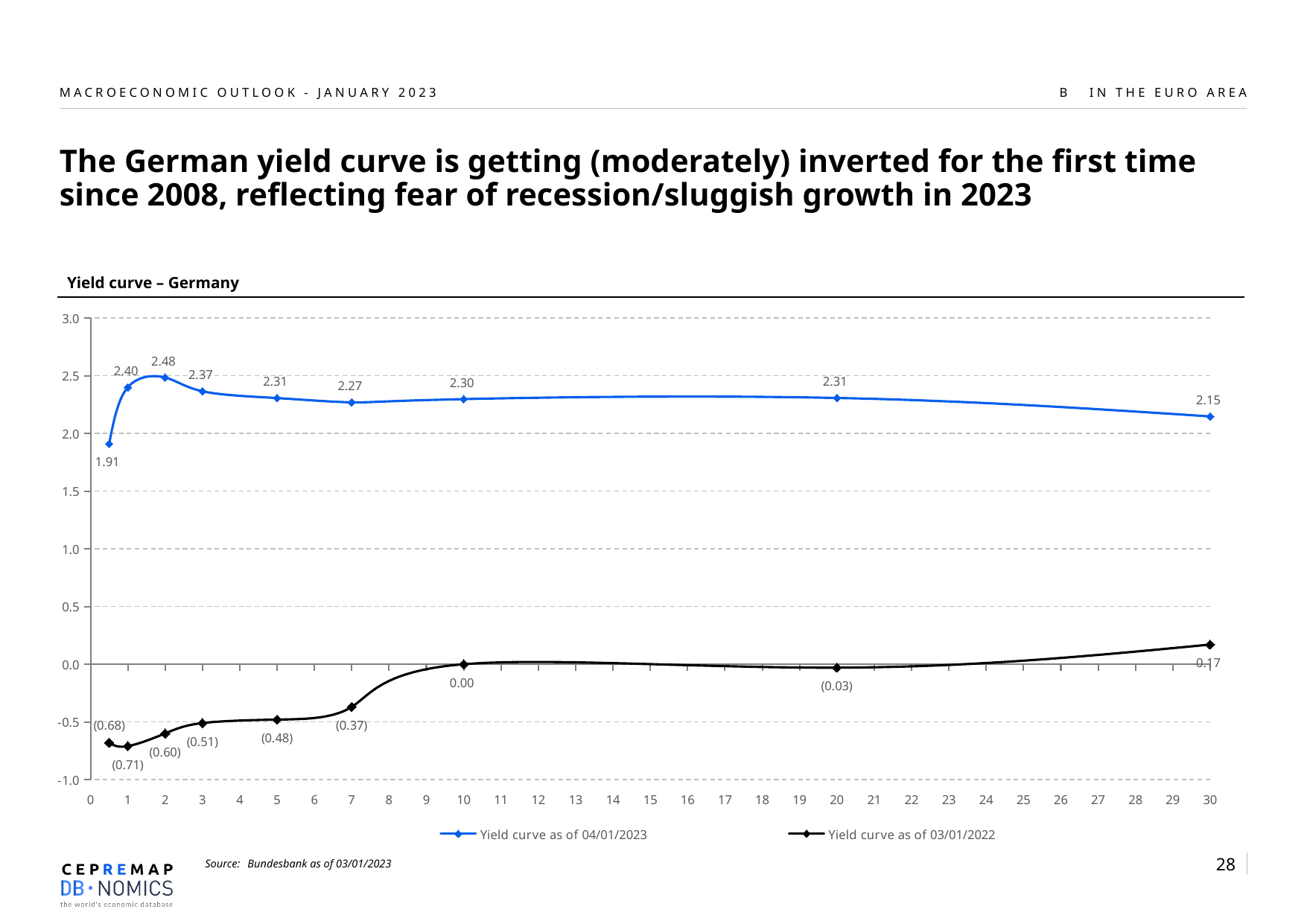
At which maturity does the yield curve as of 04/01/2023 reach its highest value? 2 What is the value of the yield curve as of 04/01/2023 at maturity 2? 2.48 What is the value of the yield curve as of 03/01/2022 at maturity 10? 0.00 What type of chart is shown on the slide? line chart What is the value of the yield curve as of 04/01/2023 at maturity 30? 2.15 How many series does the legend list? 2 What is the difference between the yield curve as of 04/01/2023 at maturity 2 and at maturity 30? 0.33 Is the value of the yield curve as of 03/01/2022 at maturity 5 greater or less than 0.0? less Which is larger: the yield curve as of 04/01/2023 at maturity 10 or at maturity 7? maturity 10 What is the value of the yield curve as of 03/01/2022 at maturity 30? 0.17 What is the title of the chart? Yield curve – Germany